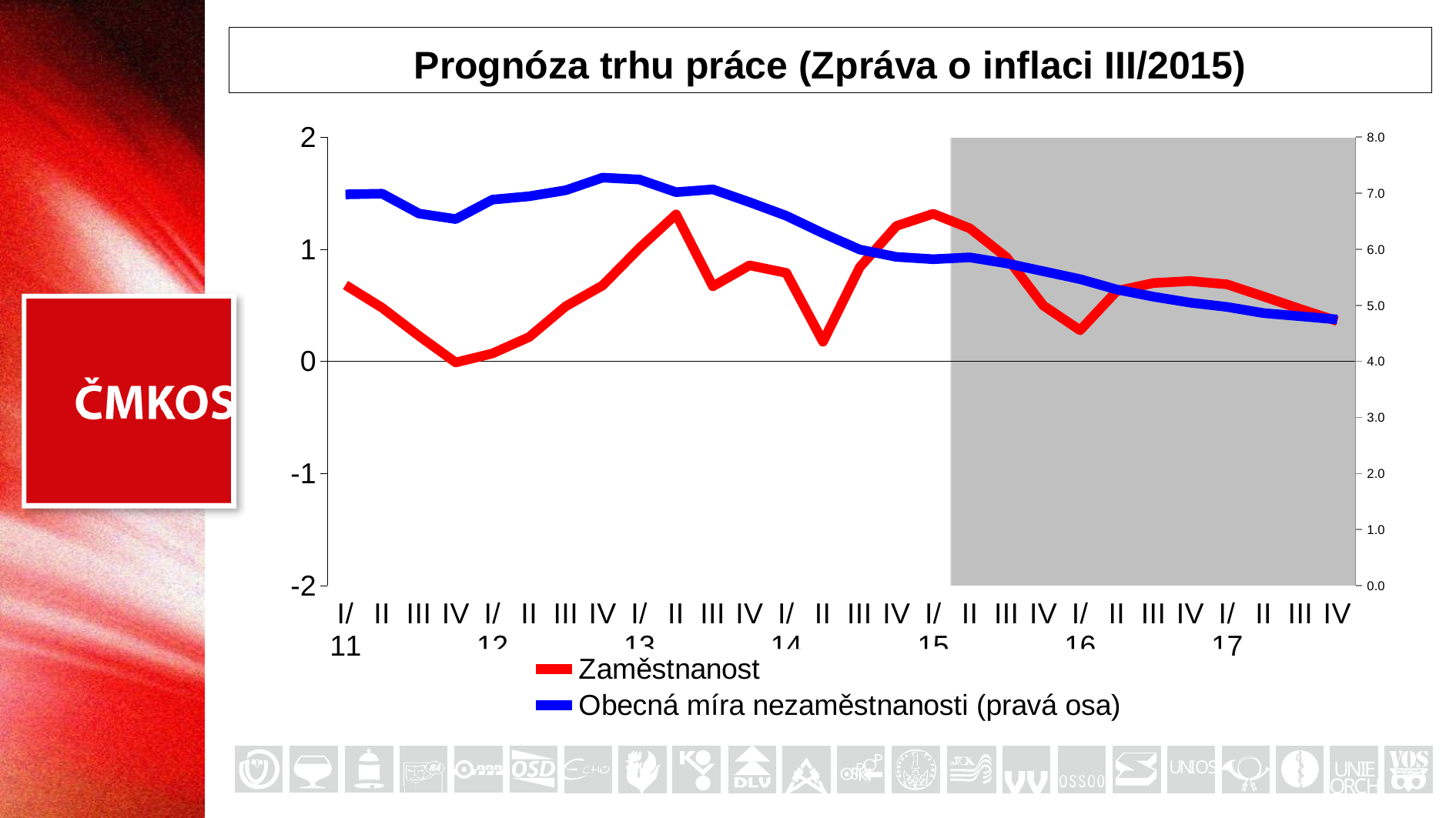
What kind of chart is shown on the slide? line chart Does the Zaměstnanost line rise or fall from I/15 to I/16? fall What is the title of the chart? Prognóza trhu práce (Zpráva o inflaci III/2015) How many series does the legend list? 2 Is the value of Zaměstnanost at II/13 greater or less than 1 on the left axis? greater Does the Obecná míra nezaměstnanosti line overall rise or fall from I/11 to IV/17? fall Which is larger for Zaměstnanost: the value at IV/11 or the value at II/13? II/13 Is the value of Obecná míra nezaměstnanosti at IV/17 greater or less than 6.0 on the right axis? less Which series is plotted against the right axis according to the legend? Obecná míra nezaměstnanosti (pravá osa) Is the value of Zaměstnanost at I/16 greater or less than 1 on the left axis? less Which is larger for Obecná míra nezaměstnanosti: the value at I/11 or the value at IV/17? I/11